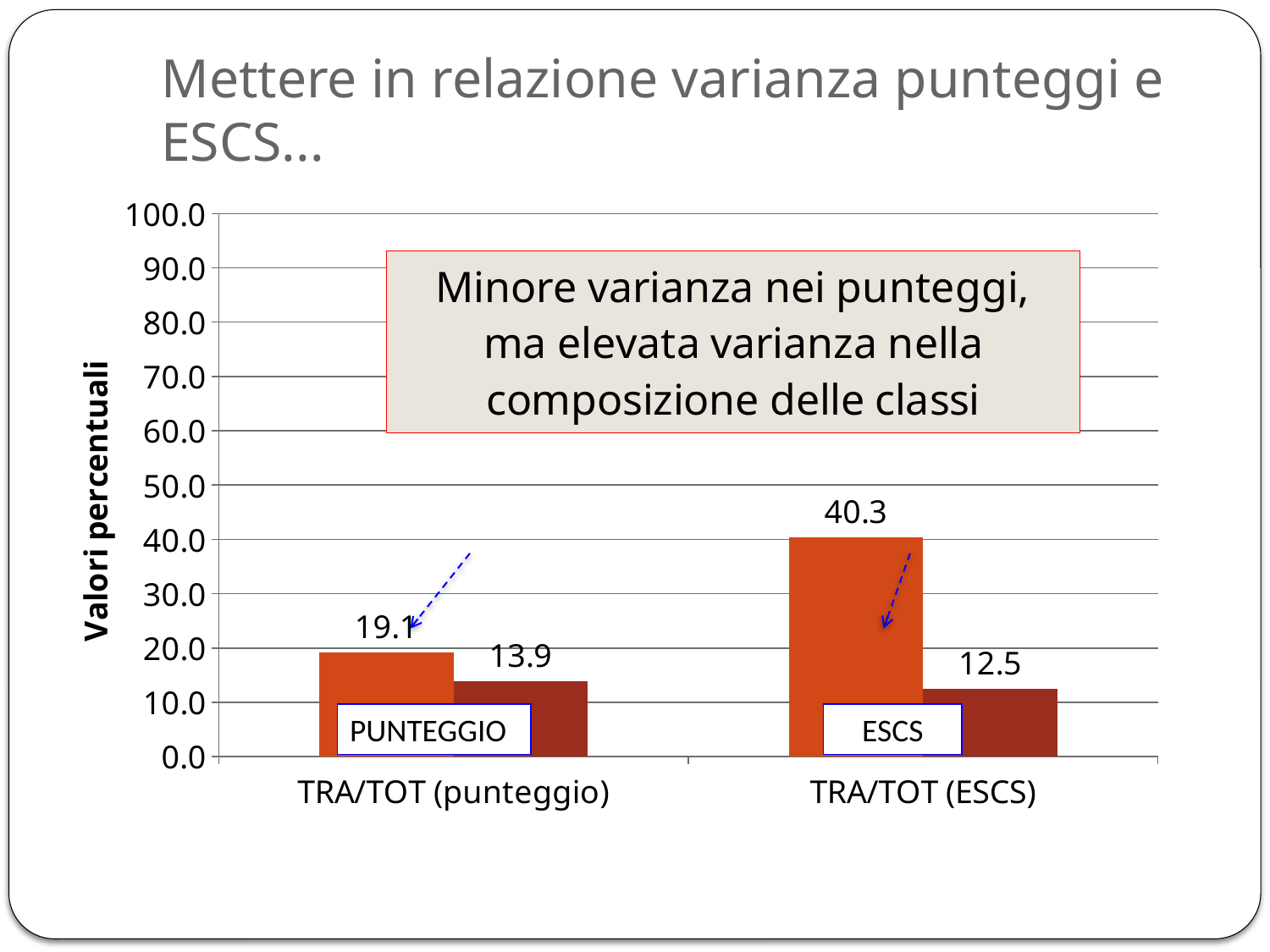
What is the value of the orange bar for TRA/TOT (ESCS)? 40.3 What is the difference between the orange bar values for TRA/TOT (ESCS) and TRA/TOT (punteggio)? 21.2 Which bar has the highest value in the chart? The orange bar for TRA/TOT (ESCS) What is the label of the vertical axis? Valori percentuali What kind of chart is shown on the slide? Bar chart How many categories are shown on the x axis? 2 What is the value of the orange bar for TRA/TOT (punteggio)? 19.1 Which bar has the lowest value in the chart? The dark red bar for TRA/TOT (ESCS) What is the value of the dark red bar for TRA/TOT (ESCS)? 12.5 Which is larger: the dark red bar for TRA/TOT (punteggio) or the dark red bar for TRA/TOT (ESCS)? TRA/TOT (punteggio) What is the value of the dark red bar for TRA/TOT (punteggio)? 13.9 What is the difference between the orange and dark red bars for TRA/TOT (punteggio)? 5.2